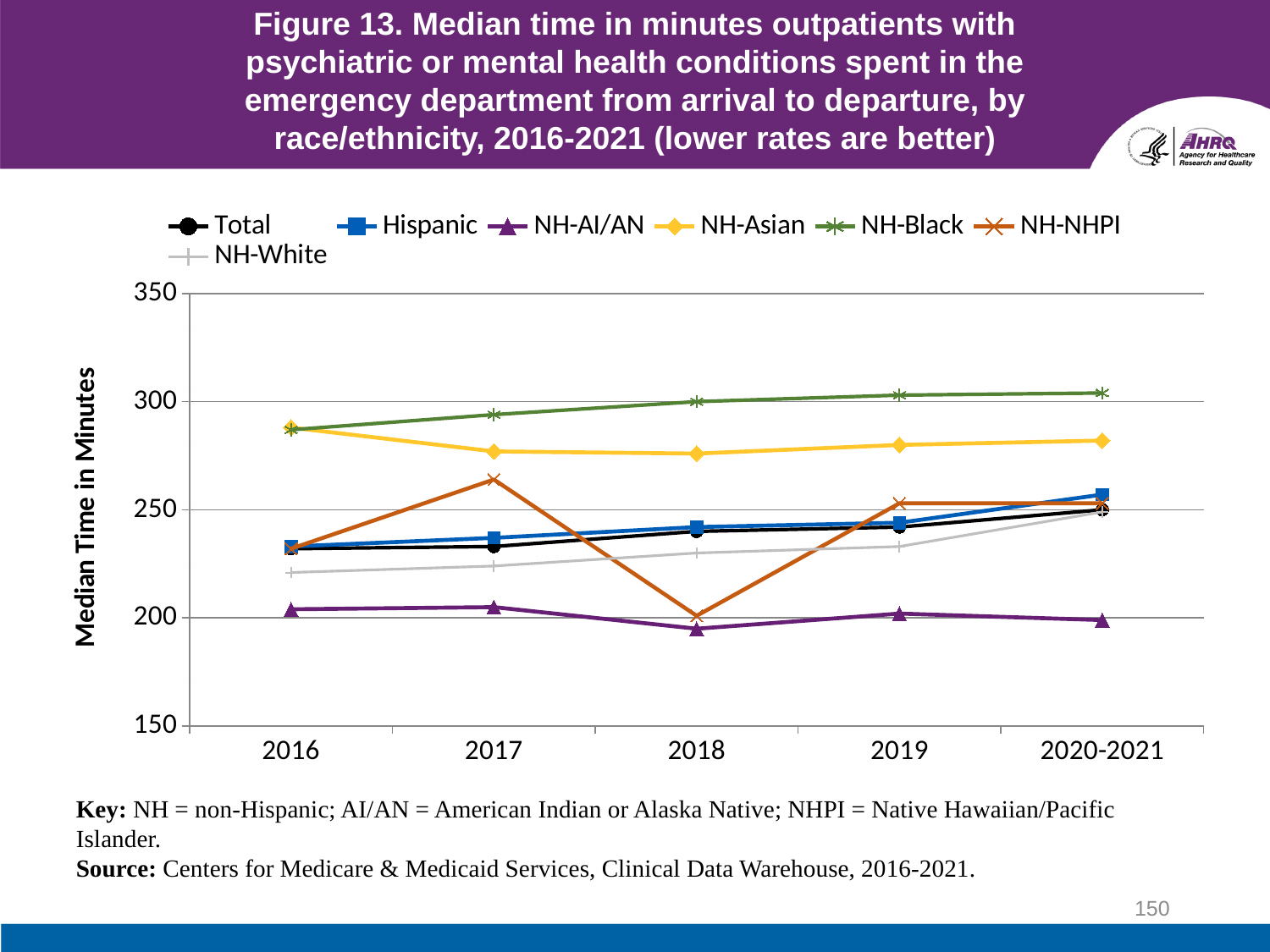
Which race/ethnicity group had the highest median time in 2020-2021? NH-Black What is the title of the y axis? Median Time in Minutes Does the median time for NH-Black rise or fall from 2016 to 2020-2021? Rise What kind of chart is shown on the slide? Line chart In 2019, which had the larger median time, NH-Asian or NH-Black? NH-Black Which race/ethnicity group had the lowest median time in 2020-2021? NH-AI/AN Is the value for NH-AI/AN in 2018 greater or less than 200? less Is the value for NH-NHPI in 2017 greater or less than 250? greater Which race/ethnicity group had the lowest median time in 2016? NH-AI/AN How many time periods are shown along the x axis? 5 Is the value for NH-Asian in 2017 greater or less than 300? less How many series does the legend list? 7